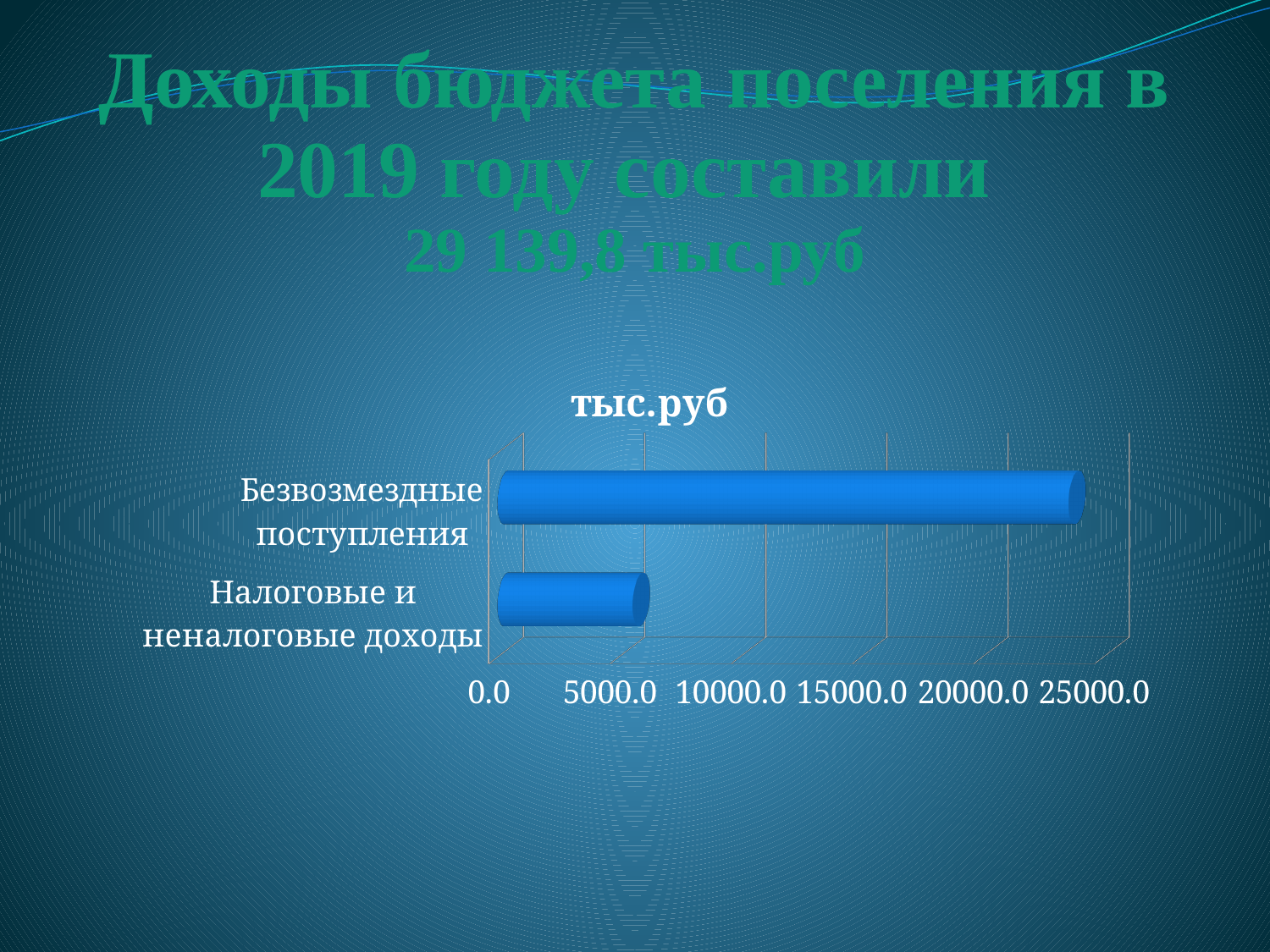
Is the value for Налоговые и неналоговые доходы greater or less than 15000.0? less Is the value for Безвозмездные поступления greater or less than 20000.0? greater Which category has the highest value? Безвозмездные поступления What is the title of the chart? тыс.руб Which is larger: Безвозмездные поступления or Налоговые и неналоговые доходы? Безвозмездные поступления Is the value for Налоговые и неналоговые доходы greater or less than 10000.0? less What is the highest value shown on the chart's value axis? 25000.0 How many categories does the chart show? 2 What kind of chart is shown on the slide? bar chart Which category has the lowest value? Налоговые и неналоговые доходы